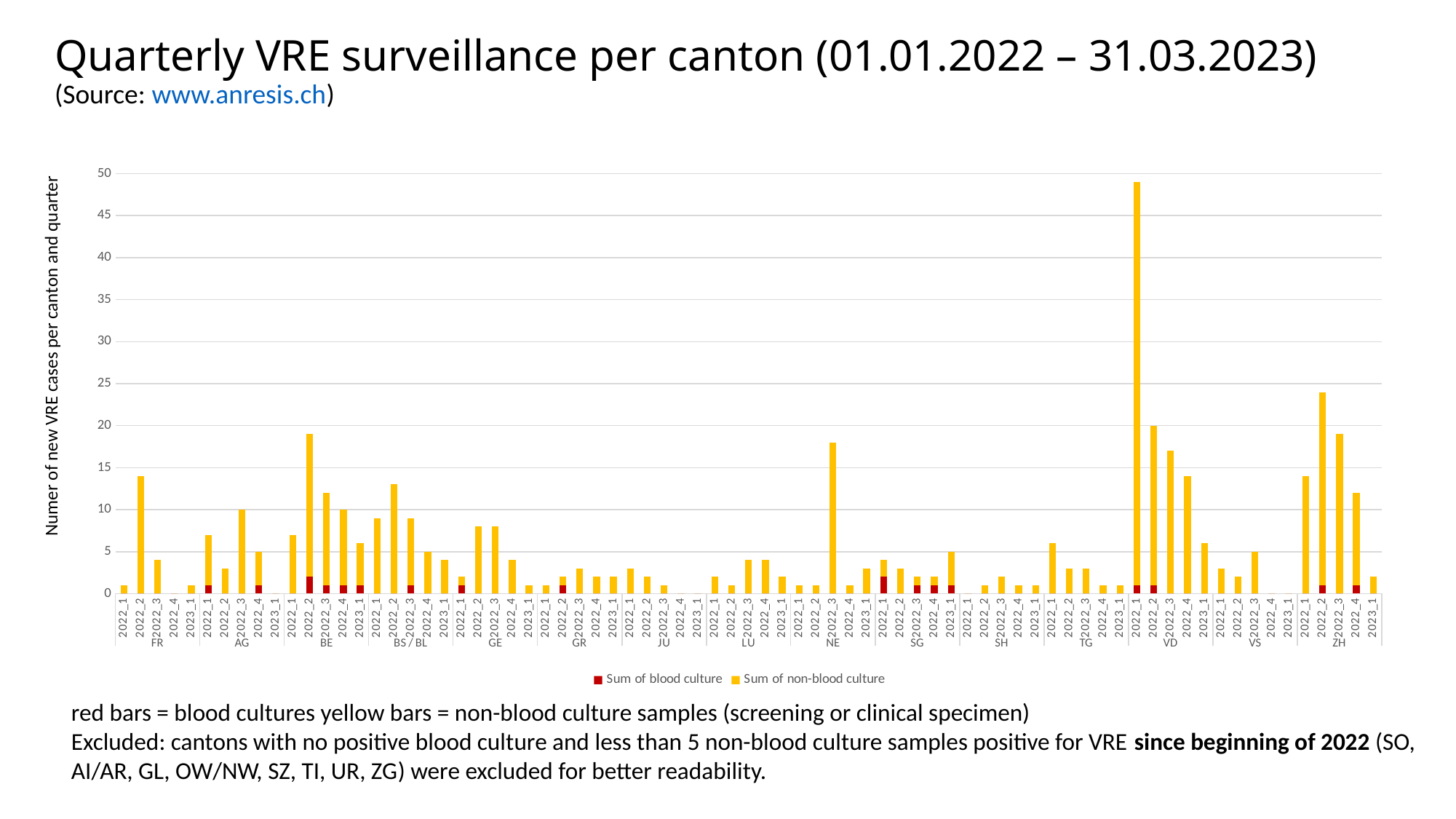
Is the value for NE in 2022_3 greater or less than 15? greater Is the value for ZH in 2022_2 greater or less than 20? greater How many series does the legend list? 2 Which is larger, the bar for FR in 2022_2 or the bar for AG in 2022_3? FR in 2022_2 Do the bars for VD rise or fall from 2022_1 to 2023_1? fall Which colour represents 'Sum of blood culture' in the legend? Red How many quarters are shown for each canton? 5 What kind of chart is shown on the slide? Stacked bar chart Which is larger, the bar for VD in 2022_1 or the bar for ZH in 2022_2? VD in 2022_1 How many cantons (canton groups) are shown along the x axis? 15 Is the value for VD in 2022_1 greater or less than 45? greater Which canton and quarter has the highest bar in the chart? VD, 2022_1